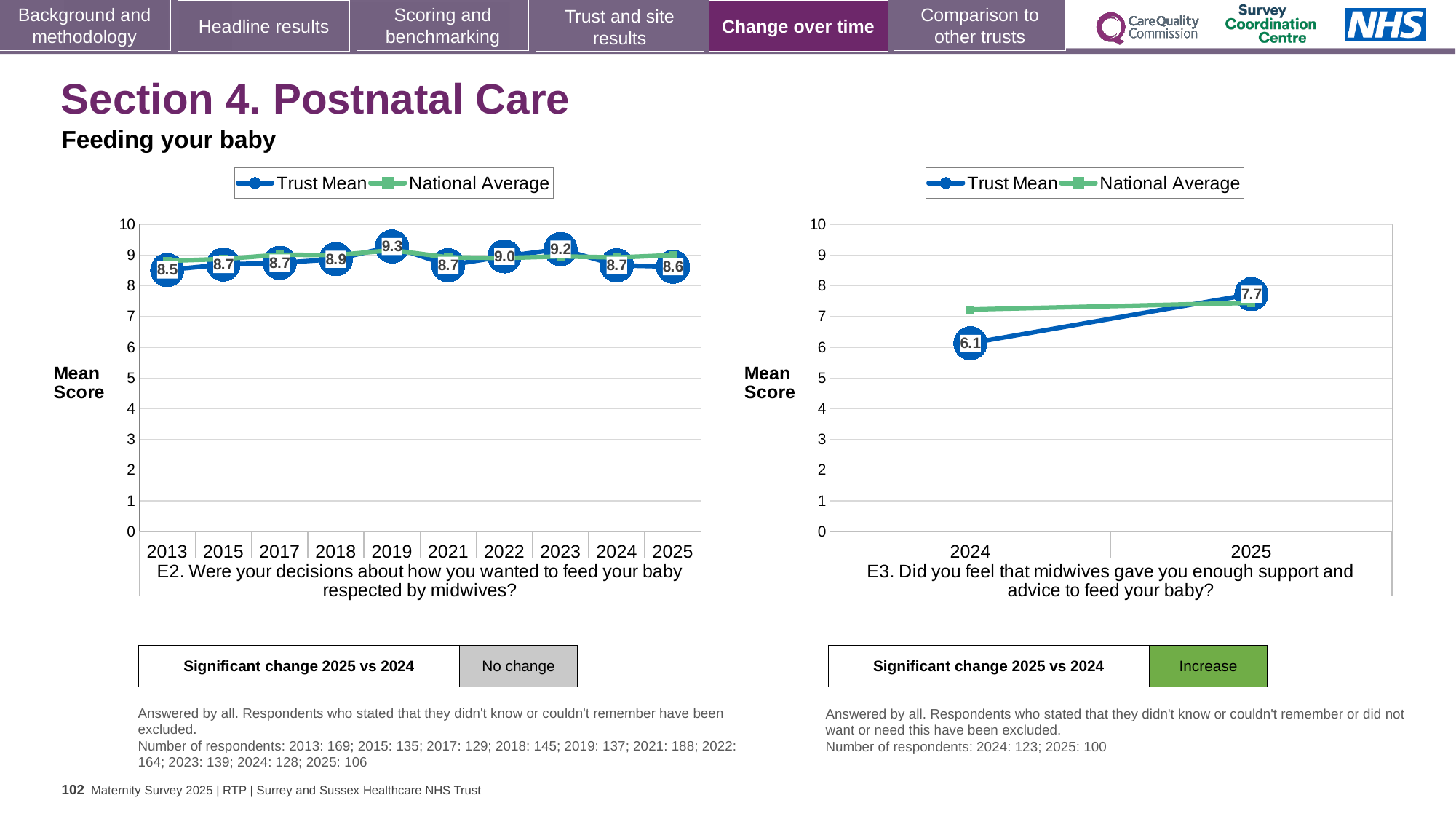
How many years are plotted on the x axis of the E2 chart on the left? 10 How many series does the legend of the E3 chart on the right list? 2 In the E3 chart on the right, does the Trust Mean rise or fall from 2024 to 2025? Rise What kind of chart is the E3 chart on the right? Line chart In the E2 chart on the left, what is the Trust Mean for 2019? 9.3 In the E3 chart on the right, what is the Trust Mean for 2025? 7.7 In the E2 chart on the left, is the Trust Mean higher in 2023 or in 2024? 2023 In the E2 chart on the left, which year has the highest Trust Mean? 2019 In the E2 chart on the left, what is the Trust Mean for 2013? 8.5 In the E3 chart on the right, what is the difference between the Trust Mean for 2025 and 2024? 1.6 In the E2 chart on the left, which year has the lowest Trust Mean? 2013 In the E3 chart on the right, is the National Average for 2024 greater or less than 8? less